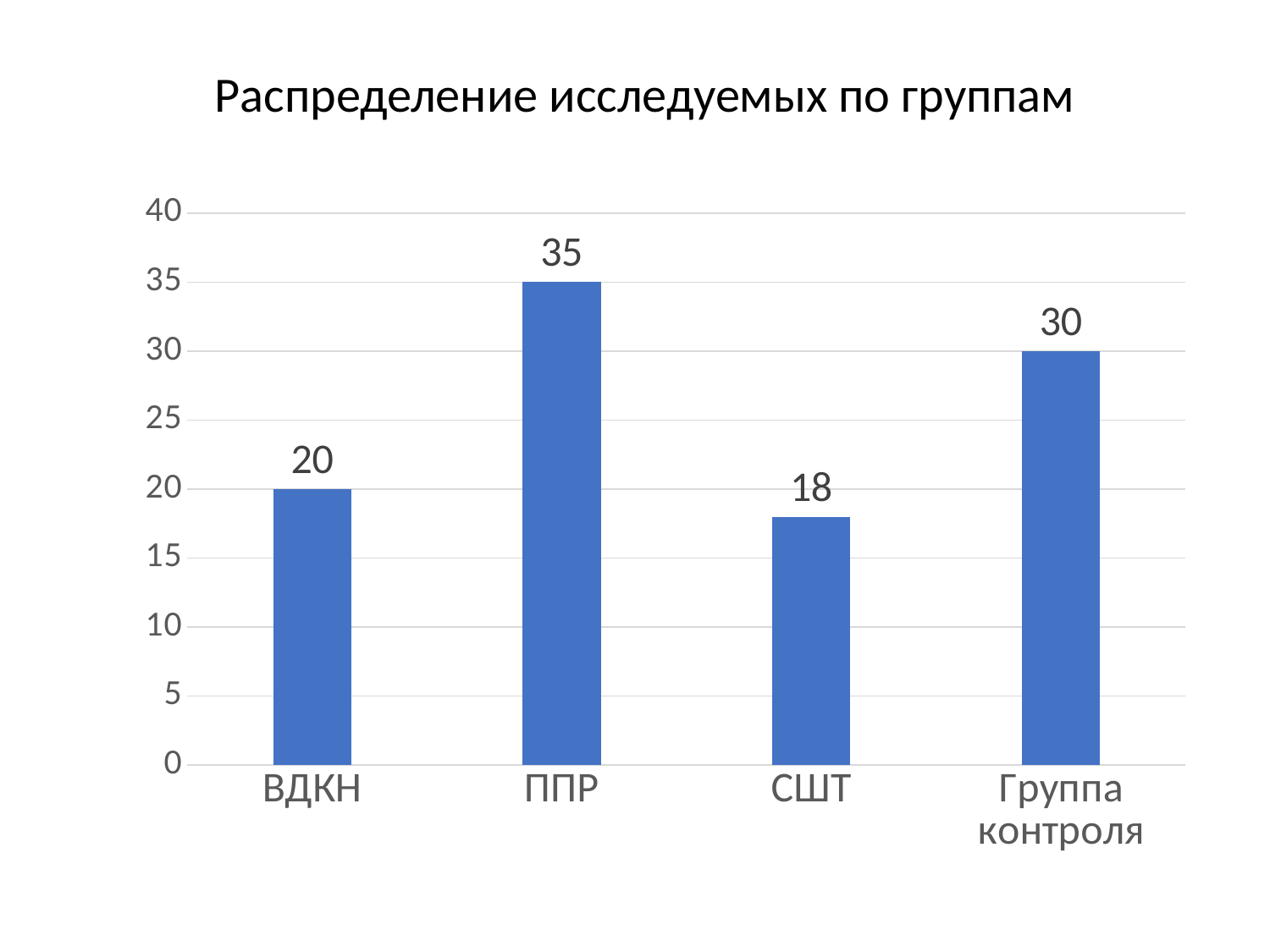
What is the value for ВДКН? 20 Which category has the lowest value? СШТ What is the value for СШТ? 18 What is the difference between the values for Группа контроля and ВДКН? 10 How many categories are shown on the chart? 4 What is the value for Группа контроля? 30 What is the difference between the values for ППР and СШТ? 17 What is the title of the chart? Распределение исследуемых по группам What is the value for ППР? 35 What kind of chart is shown on the slide? Bar chart Which category has the highest value? ППР Which is larger, the value for ВДКН or the value for Группа контроля? Группа контроля